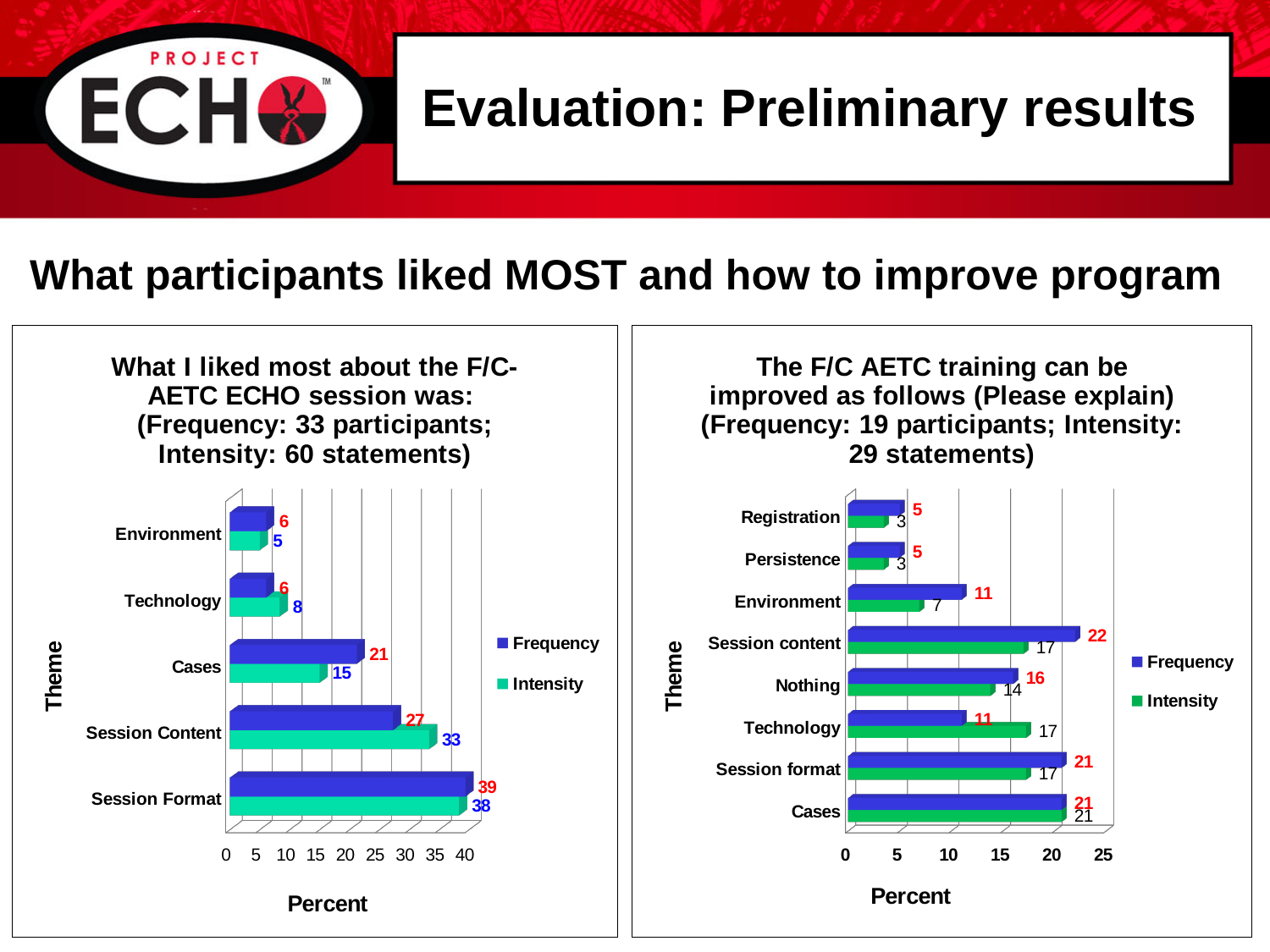
In the left chart (What I liked most about the F/C-AETC ECHO session was), which theme has the highest Frequency value? Session Format In the right chart (The F/C AETC training can be improved as follows), is the Frequency value for Technology larger or smaller than its Intensity value? smaller In the right chart (The F/C AETC training can be improved as follows), what is the Intensity value for Nothing? 14 In the left chart (What I liked most about the F/C-AETC ECHO session was), what is the difference between the Frequency and Intensity values for Cases? 6 In the left chart (What I liked most about the F/C-AETC ECHO session was), what is the Frequency value for Session Format? 39 In the left chart (What I liked most about the F/C-AETC ECHO session was), which theme has the lowest Intensity value? Environment In the left chart (What I liked most about the F/C-AETC ECHO session was), how many themes are plotted? 5 In the left chart (What I liked most about the F/C-AETC ECHO session was), what is the Intensity value for Session Content? 33 In the right chart (The F/C AETC training can be improved as follows), what is the Frequency value for Session content? 22 In the right chart (The F/C AETC training can be improved as follows), how many themes are plotted? 8 In the right chart (The F/C AETC training can be improved as follows), which theme has the highest Frequency value? Session content What type of chart is used in the right chart (The F/C AETC training can be improved as follows)? Bar chart